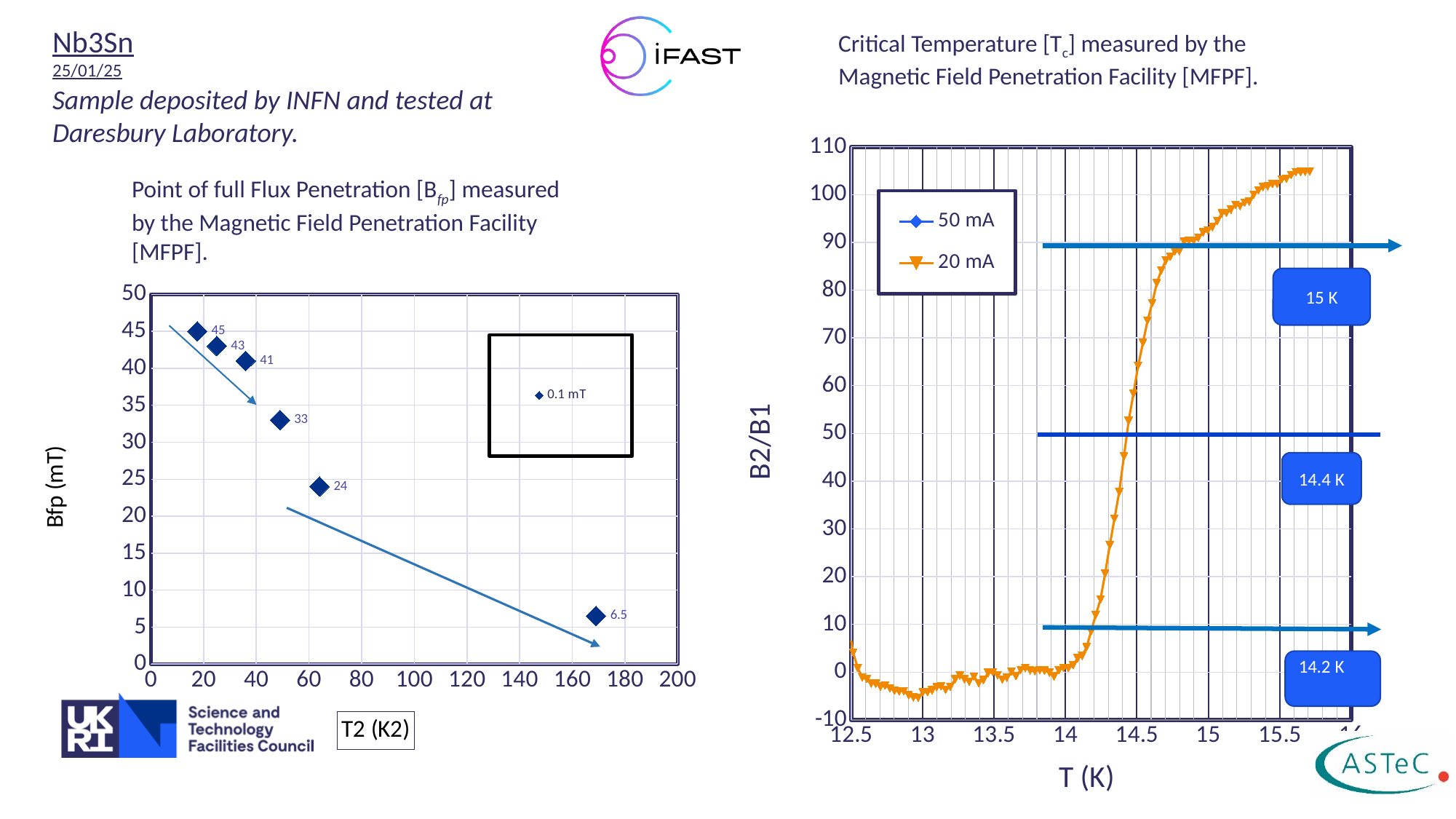
In the left chart (Bfp vs T2), how many data points are plotted? 6 In the left chart (Bfp vs T2), what is the legend entry shown? 0.1 mT In the right chart (B2/B1 vs T), is the value at T = 13 K greater or less than 10? less In the left chart (Bfp vs T2), what is the lowest labelled Bfp value? 6.5 In the left chart (Bfp vs T2), what is the difference between the highest and lowest labelled values? 38.5 In the right chart (B2/B1 vs T), is the value at T = 15 K greater or less than 80? greater In the right chart (B2/B1 vs T), does B2/B1 rise or fall as T increases from 14 K to 15.5 K? rise In the right chart (B2/B1 vs T), what are the two legend entries? 50 mA and 20 mA In the left chart (Bfp vs T2), what is the highest labelled Bfp value? 45 In the left chart (Bfp vs T2), do the Bfp values rise or fall as T2 increases? fall In the right chart (B2/B1 vs T), how many series does the legend list? 2 In the left chart (Bfp vs T2), what is the labelled value of the point near T2 = 60? 24